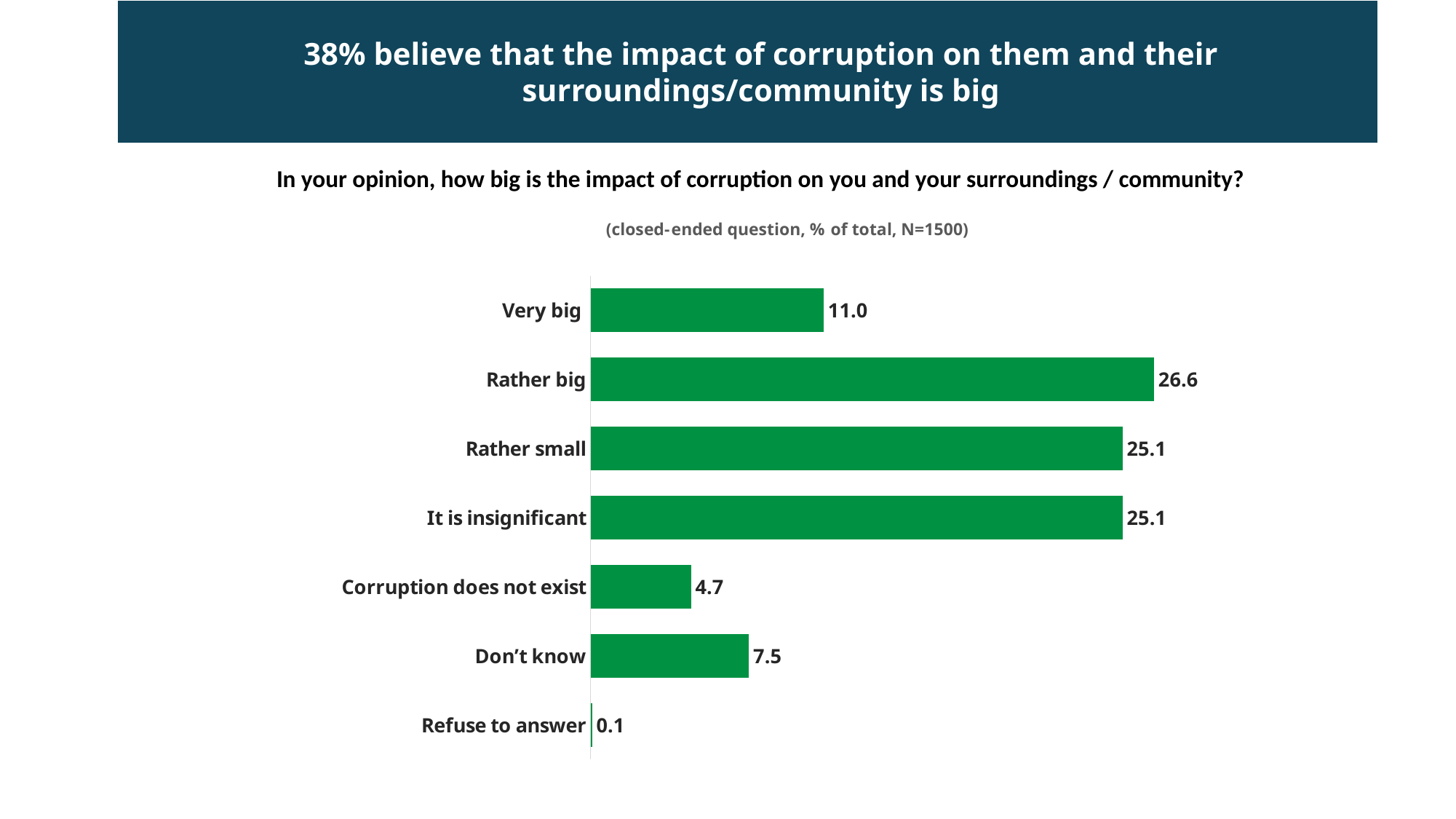
What sample size (N) is stated in the chart subtitle? N=1500 Which category has the lowest value? Refuse to answer What is the value for "Very big"? 11.0 Which is larger, the value for "Don't know" or the value for "Corruption does not exist"? Don't know What is the difference between the values for "Rather big" and "Rather small"? 1.5 How many categories are shown in the chart? 7 What is the value for "Refuse to answer"? 0.1 What is the value for "Rather big"? 26.6 What is the value for "Corruption does not exist"? 4.7 Which category has the highest value? Rather big What kind of chart is shown on the slide? Bar chart What is the difference between the values for "Very big" and "Don't know"? 3.5